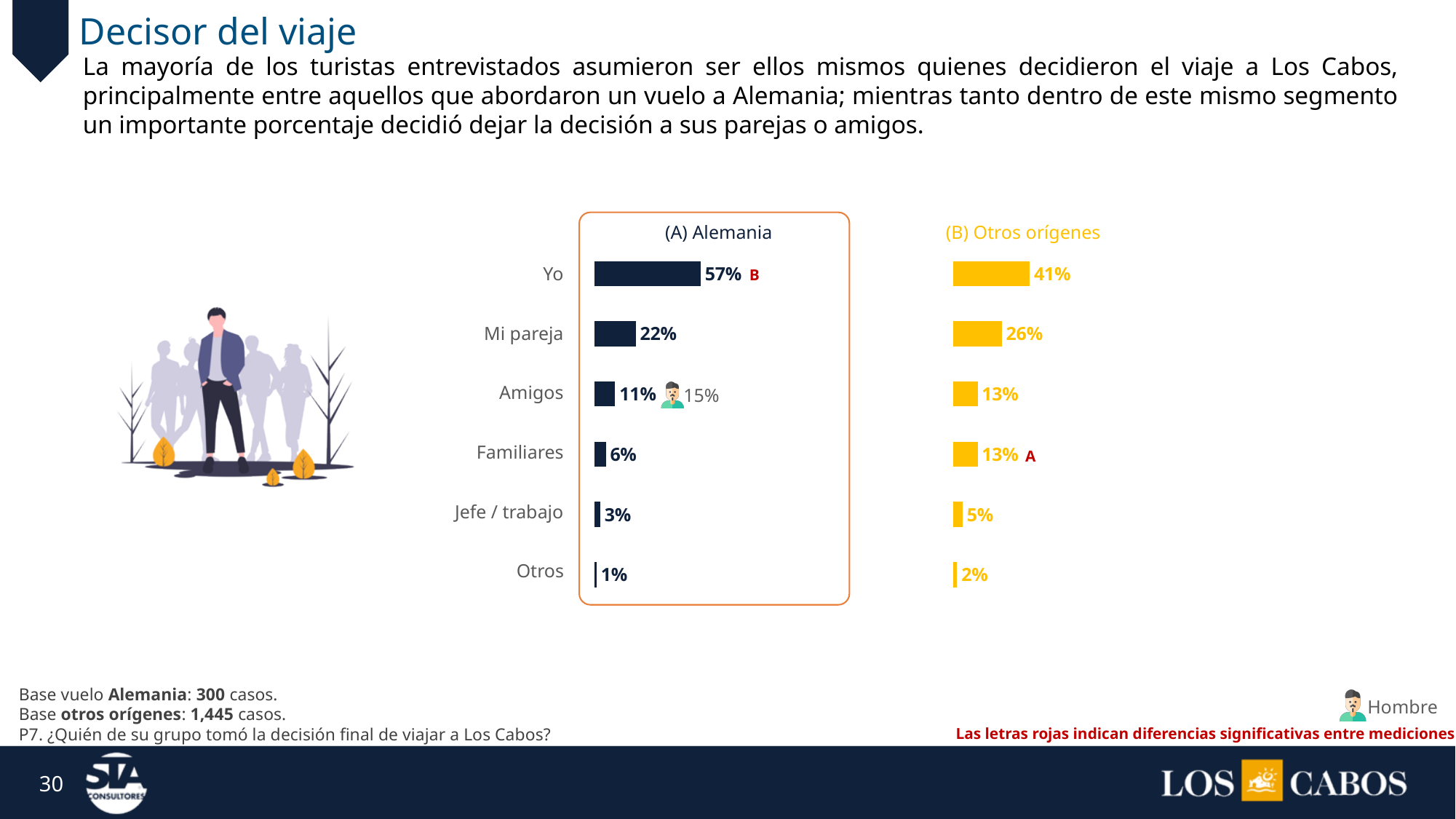
In the (A) Alemania chart, which category has the highest value? Yo How many categories are shown in the (A) Alemania chart? 6 In the (B) Otros orígenes chart, what is the value for Mi pareja? 26% What is the difference between the Yo values in the (A) Alemania chart and the (B) Otros orígenes chart? 16% In the (A) Alemania chart, what is the difference between Mi pareja and Amigos? 11% In the (A) Alemania chart, what is the value for Yo? 57% In the (A) Alemania chart, what is the value for Familiares? 6% In the (B) Otros orígenes chart, which category has the lowest value? Otros What colour are the bars in the (B) Otros orígenes chart? Yellow Which is larger: Familiares in the (A) Alemania chart or Familiares in the (B) Otros orígenes chart? (B) Otros orígenes In the (B) Otros orígenes chart, what is the value for Jefe / trabajo? 5% What kind of chart is the (B) Otros orígenes chart? Bar chart